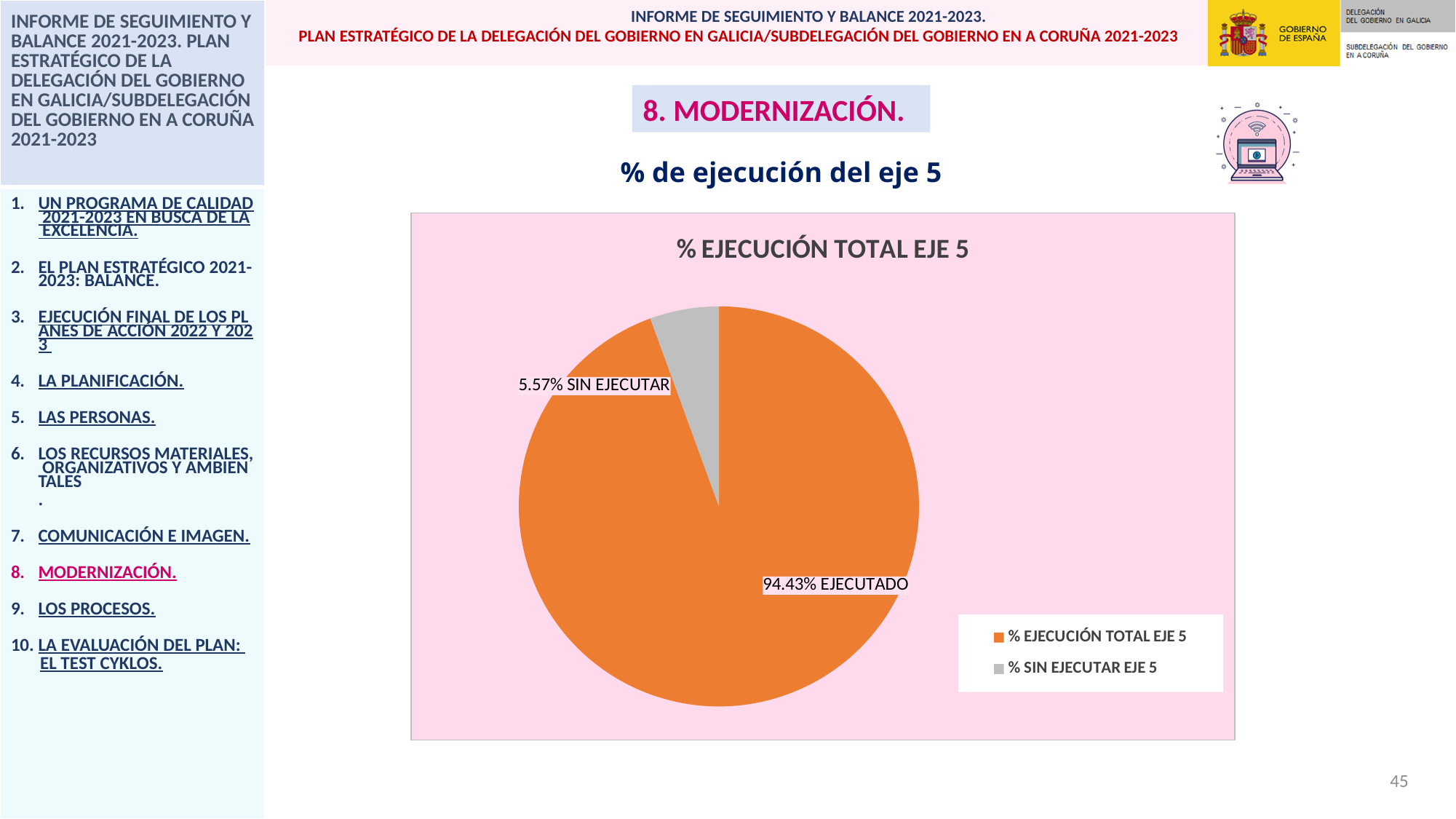
What type of chart is shown on the slide? pie chart Which slice of the pie is the smallest? 5.57% SIN EJECUTAR Which is larger, the EJECUTADO slice or the SIN EJECUTAR slice? EJECUTADO Which slice of the pie is the largest? 94.43% EJECUTADO What percentage of eje 5 is labelled as EJECUTADO? 94.43% What percentage of eje 5 is labelled as SIN EJECUTAR? 5.57% What is the title of the chart? % EJECUCIÓN TOTAL EJE 5 What colour is the slice for % SIN EJECUTAR EJE 5? grey How many entries does the legend list? 2 Is the EJECUTADO share greater or less than 90%? greater What is the difference between the EJECUTADO share and the SIN EJECUTAR share? 88.86% How many slices does the pie chart have? 2